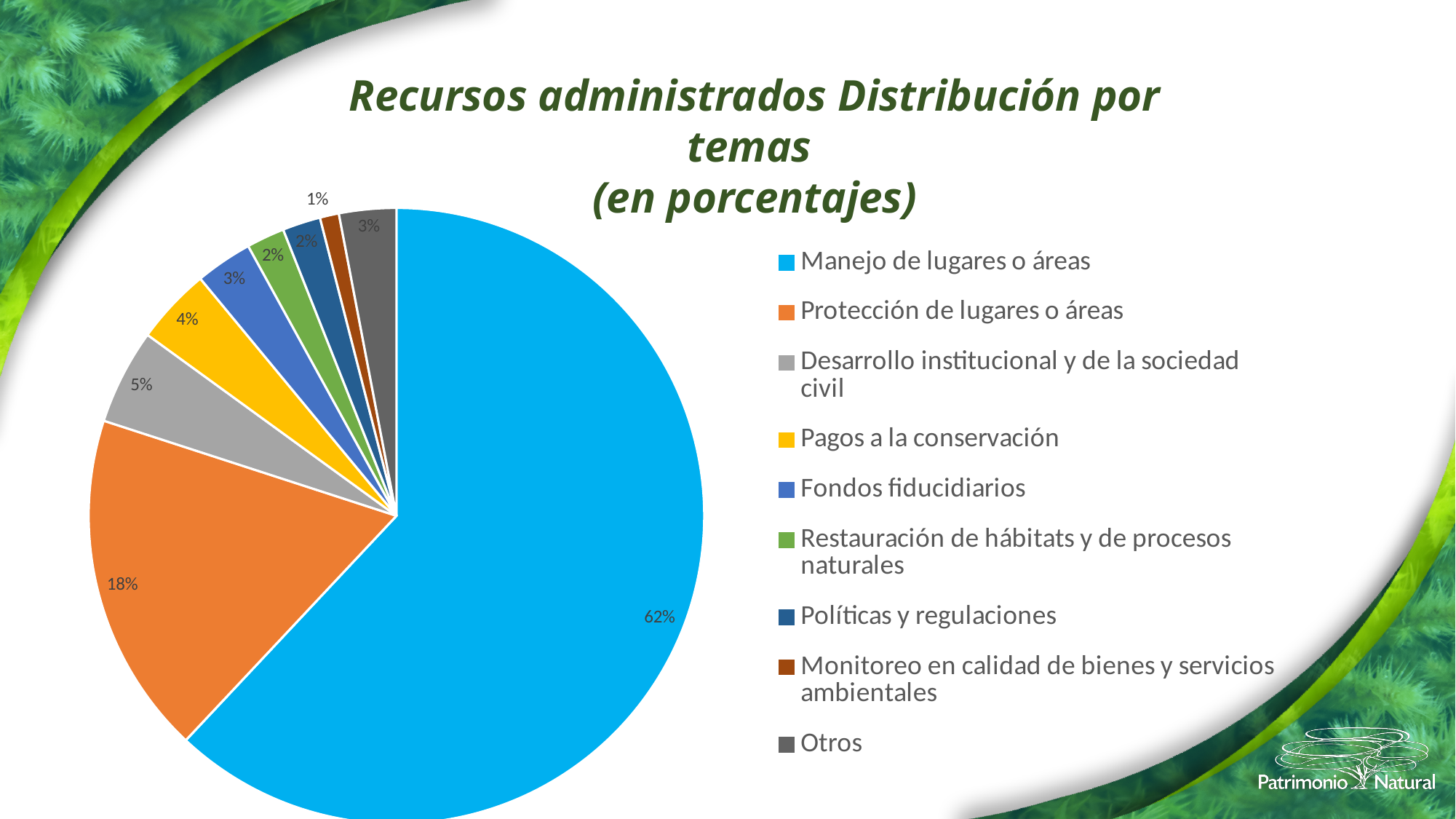
What percentage is shown for Otros? 3% How many categories does the legend list? 9 Which is larger, the share for Desarrollo institucional y de la sociedad civil or the share for Fondos fiducidiarios? Desarrollo institucional y de la sociedad civil What is the difference in percentage points between Manejo de lugares o áreas and Protección de lugares o áreas? 44 What percentage is shown for Protección de lugares o áreas? 18% What kind of chart is shown on the slide? Pie chart Which category has the largest share of the pie? Manejo de lugares o áreas Which category has the smallest share of the pie? Monitoreo en calidad de bienes y servicios ambientales What colour is the slice for Pagos a la conservación? Yellow What percentage is shown for Pagos a la conservación? 4% What is the title of the chart? Recursos administrados Distribución por temas (en porcentajes) What percentage is shown for Manejo de lugares o áreas? 62%